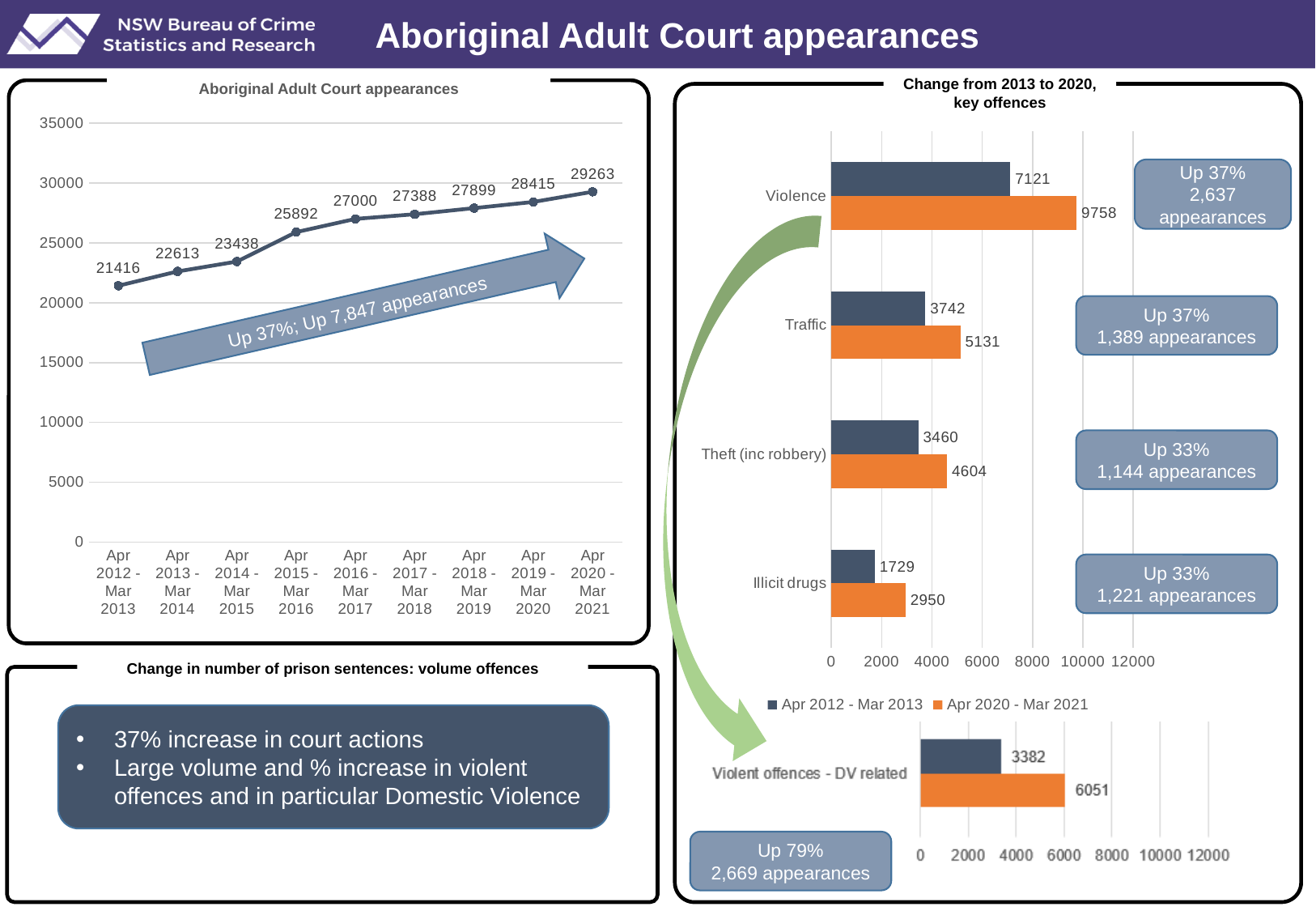
In the 'Aboriginal Adult Court appearances' line chart, what is the value for Apr 2020 - Mar 2021? 29263 In the 'Aboriginal Adult Court appearances' line chart, do the values rise or fall from left to right? rise In the 'Aboriginal Adult Court appearances' line chart, what is the difference between the Apr 2015 - Mar 2016 value and the Apr 2014 - Mar 2015 value? 2454 In the 'Aboriginal Adult Court appearances' line chart, how many data points are plotted? 9 In the 'Change from 2013 to 2020, key offences' chart, what is the difference between the Apr 2020 - Mar 2021 and Apr 2012 - Mar 2013 values for Traffic? 1389 In the 'Change from 2013 to 2020, key offences' chart, what is the Apr 2012 - Mar 2013 value for Illicit drugs? 1729 In the 'Change from 2013 to 2020, key offences' chart, how many series does the legend list? 2 In the 'Change from 2013 to 2020, key offences' chart, what is the Apr 2020 - Mar 2021 value for Violence? 9758 In the 'Change from 2013 to 2020, key offences' chart, which offence category has the highest Apr 2020 - Mar 2021 value? Violence In the 'Aboriginal Adult Court appearances' line chart, what is the value for Apr 2012 - Mar 2013? 21416 In the 'Violent offences - DV related' bar chart at the bottom right, what is the value of the orange (Apr 2020 - Mar 2021) bar? 6051 In the 'Aboriginal Adult Court appearances' line chart, which period has the lowest value? Apr 2012 - Mar 2013